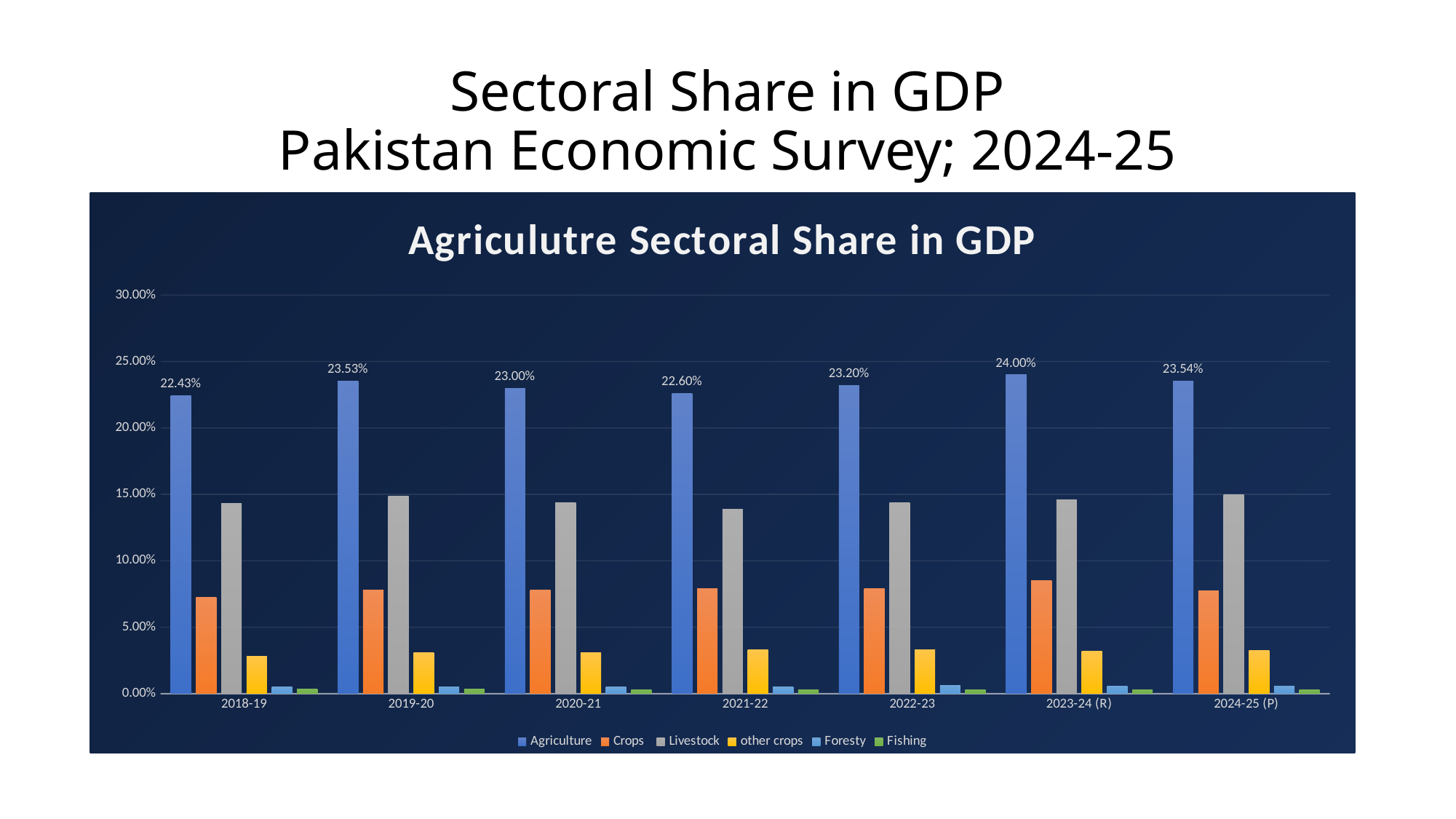
What is the Agriculture share in GDP for 2018-19? 22.43% Is the Livestock value for 2018-19 greater or less than 10.00%? greater Is the Crops value for 2023-24 (R) greater or less than 10.00%? less In which year is the Agriculture share in GDP lowest? 2018-19 What is the Agriculture share in GDP for 2024-25 (P)? 23.54% What kind of chart is shown on the slide? Bar chart How many years are shown on the x axis? 7 Which year has the larger Agriculture share: 2020-21 or 2021-22? 2020-21 How many series does the legend list? 6 In which year is the Agriculture share in GDP highest? 2023-24 (R) What is the difference between the Agriculture share in 2023-24 (R) and in 2018-19? 1.57% What is the Agriculture share in GDP for 2023-24 (R)? 24.00%